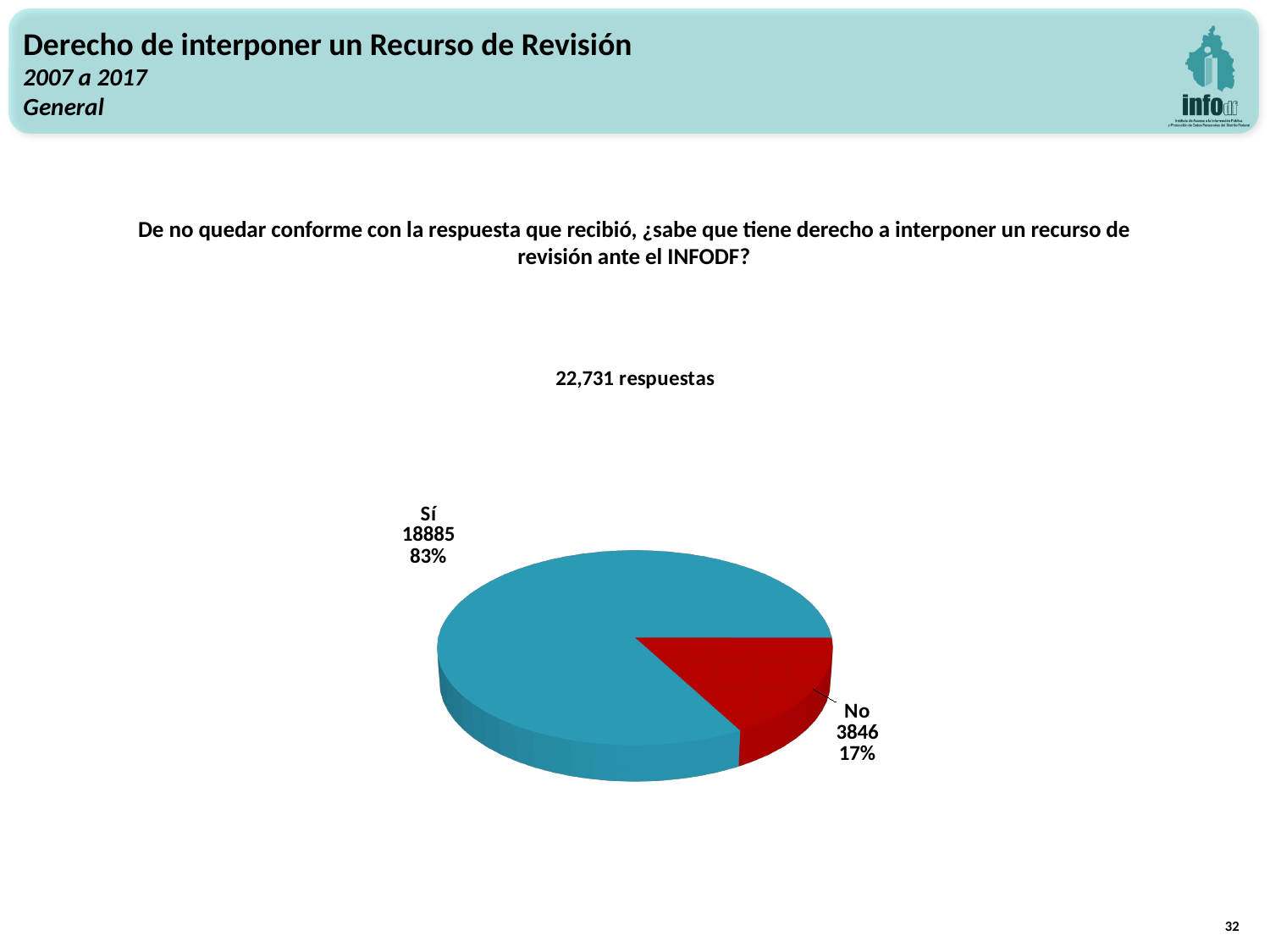
How many slices does the pie chart have? 2 Which is larger, the "Sí" slice or the "No" slice? Sí What is the value for the "No" slice? 3846 Which slice is the smallest? No What share of the pie does the "No" slice represent? 17% What is the value for the "Sí" slice? 18885 What colour is the "No" slice? red Which slice is the largest? Sí What kind of chart is shown on the slide? pie chart What is the difference between the "Sí" and "No" values? 15039 What is the title of the chart? 22,731 respuestas What share of the pie does the "Sí" slice represent? 83%